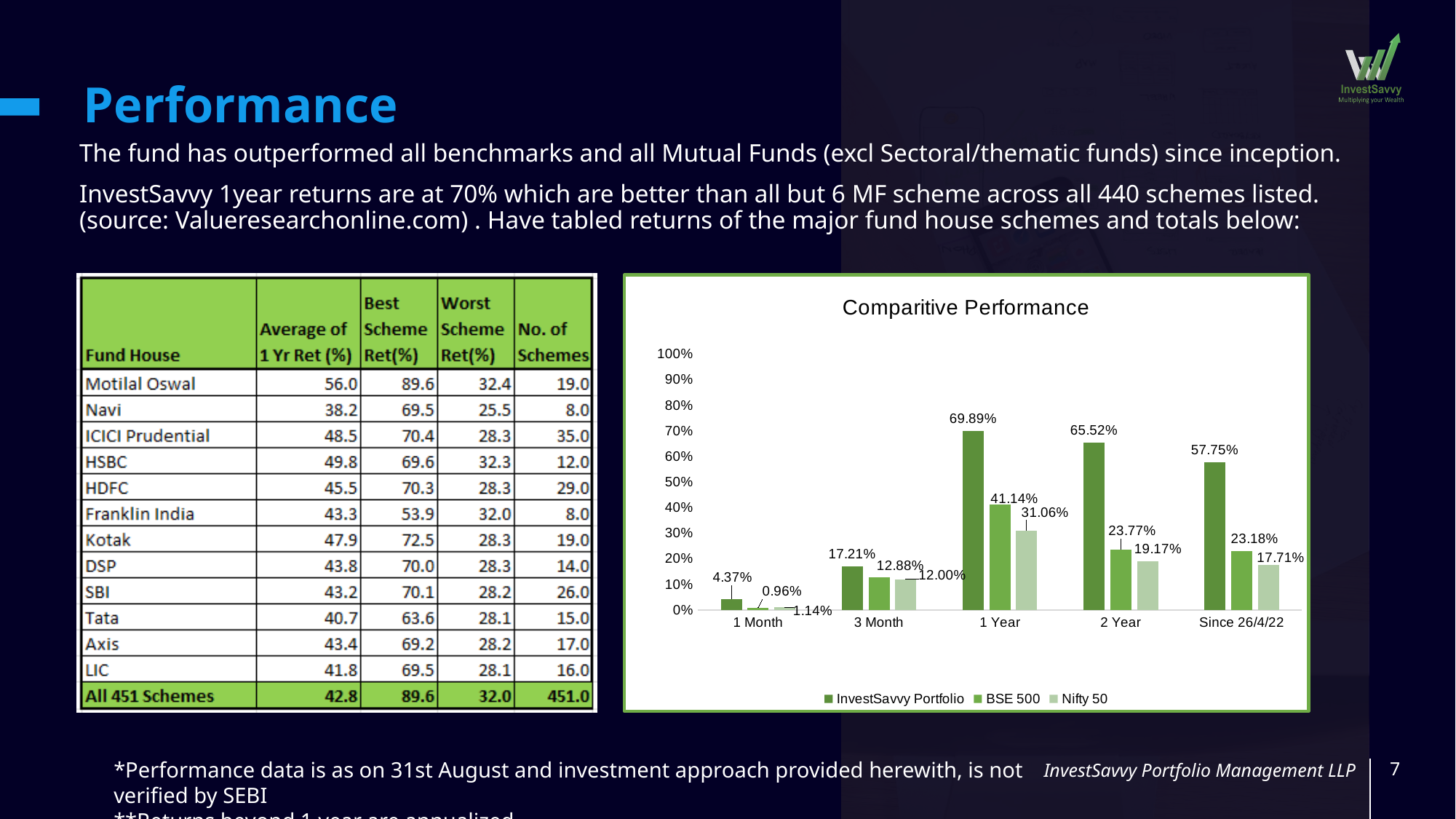
For 3 Month, which is larger in the Comparitive Performance chart: BSE 500 or Nifty 50? BSE 500 What is the difference between the InvestSavvy Portfolio and BSE 500 values for 2 Year in the Comparitive Performance chart? 41.75% How many time-period categories are shown on the x axis of the Comparitive Performance chart? 5 Is the InvestSavvy Portfolio value for Since 26/4/22 greater or less than 50% in the Comparitive Performance chart? greater What is the BSE 500 value for Since 26/4/22 in the Comparitive Performance chart? 23.18% What is the Nifty 50 value for 2 Year in the Comparitive Performance chart? 19.17% In which period does the InvestSavvy Portfolio reach its highest value in the Comparitive Performance chart? 1 Year What type of chart is shown under the title "Comparitive Performance"? bar chart What is the InvestSavvy Portfolio value for 1 Year in the Comparitive Performance chart? 69.89% In which period is the BSE 500 value lowest in the Comparitive Performance chart? 1 Month How many series does the legend of the Comparitive Performance chart list? 3 Which series is shown in the darkest green in the Comparitive Performance chart? InvestSavvy Portfolio